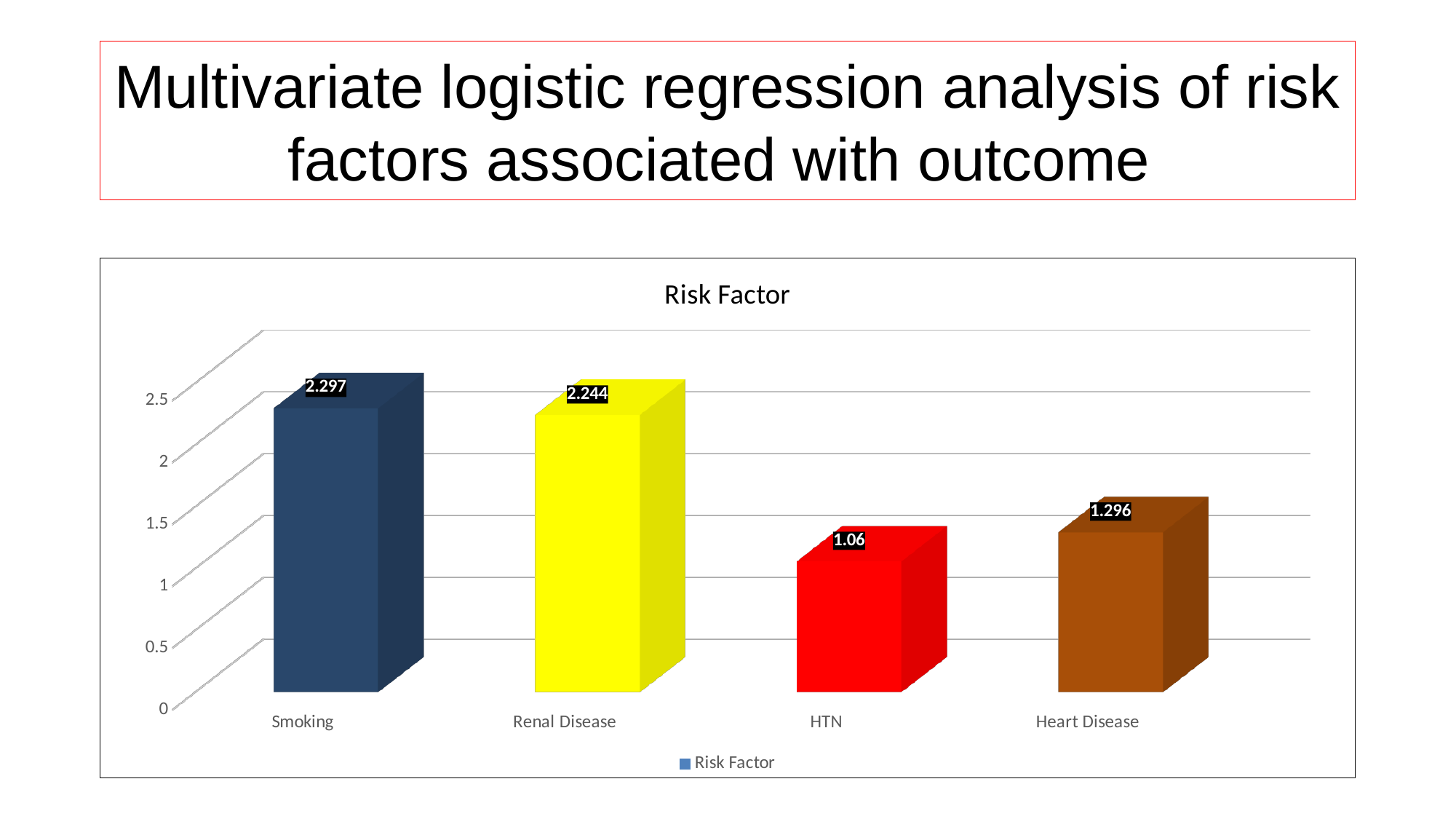
What kind of chart is shown on the slide? Bar chart What is the difference between the values for Heart Disease and HTN? 0.236 What is the value for HTN? 1.06 What is the value for Heart Disease? 1.296 Which is larger, the value for Renal Disease or the value for Heart Disease? Renal Disease Which risk factor has the highest value? Smoking Which risk factor has the lowest value? HTN What is the difference between the values for Smoking and HTN? 1.237 What is the value for Renal Disease? 2.244 How many risk factors are shown on the chart? 4 What is the title of the chart? Risk Factor What is the value for Smoking? 2.297